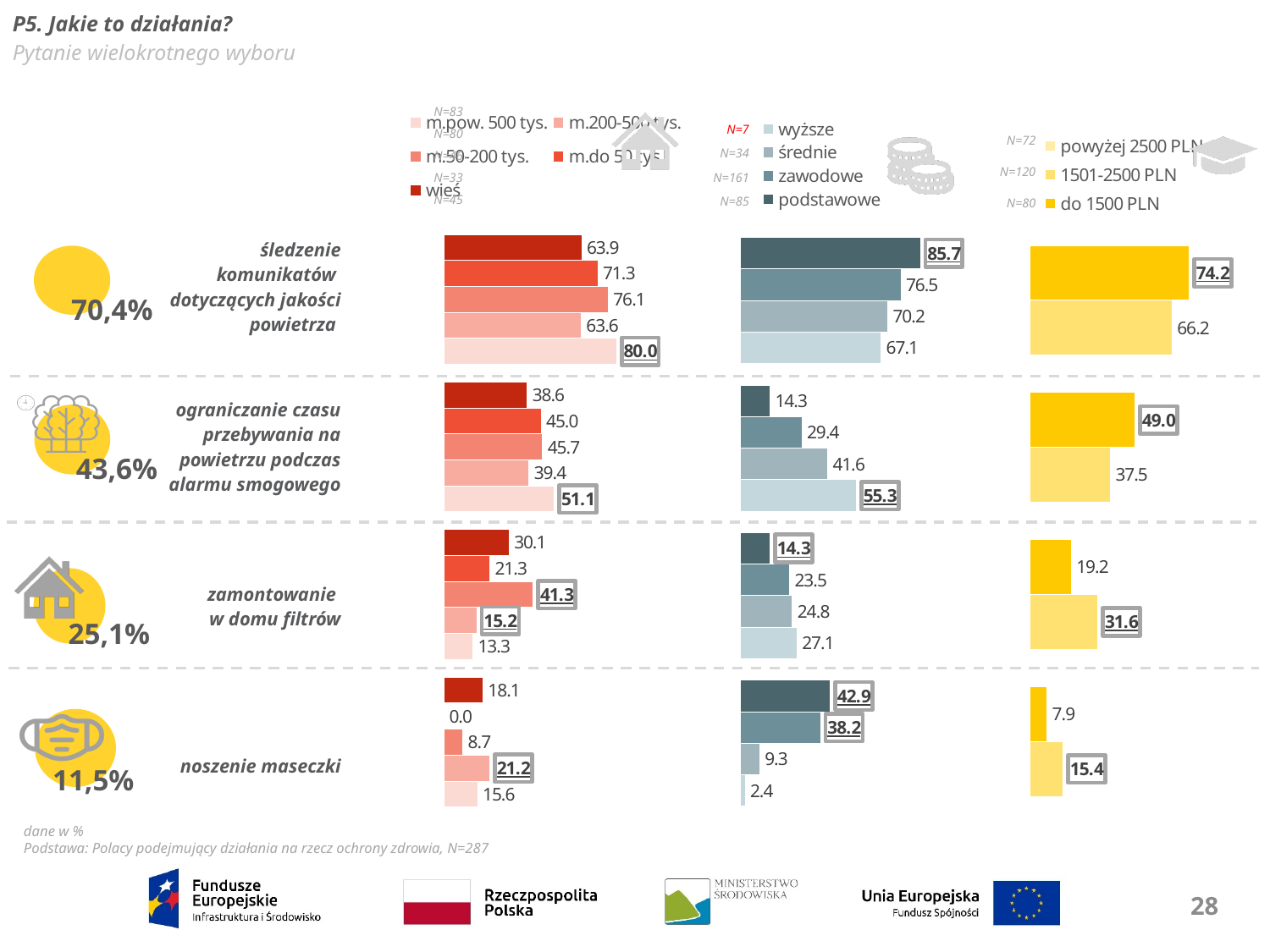
In the chart by education for 'zamontowanie w domu filtrów', what is the value for 'wyższe'? 27.1 In the chart by place of residence for 'śledzenie komunikatów dotyczących jakości powietrza', what is the value for 'm.pow. 500 tys.'? 80.0 What kind of chart is used to show the results on this slide? bar chart In the chart by education for 'noszenie maseczki', what is the difference between the values for 'podstawowe' and 'zawodowe'? 4.7 In the chart by place of residence for 'zamontowanie w domu filtrów', what is the difference between the values for 'm.50-200 tys.' and 'm.pow. 500 tys.'? 28.0 How many categories does the legend for the place-of-residence charts list? 5 What overall percentage is shown for 'ograniczanie czasu przebywania na powietrzu podczas alarmu smogowego'? 43,6% How many categories does the legend for the education charts list? 4 In the chart by education for 'śledzenie komunikatów dotyczących jakości powietrza', what is the value for 'podstawowe'? 85.7 In the chart by education for 'ograniczanie czasu przebywania na powietrzu podczas alarmu smogowego', which education category has the highest value? wyższe In the chart by place of residence for 'noszenie maseczki', which category has the lowest value? m.do 50 tys. In the chart by education for 'noszenie maseczki', which is larger: the value for 'podstawowe' or the value for 'wyższe'? podstawowe